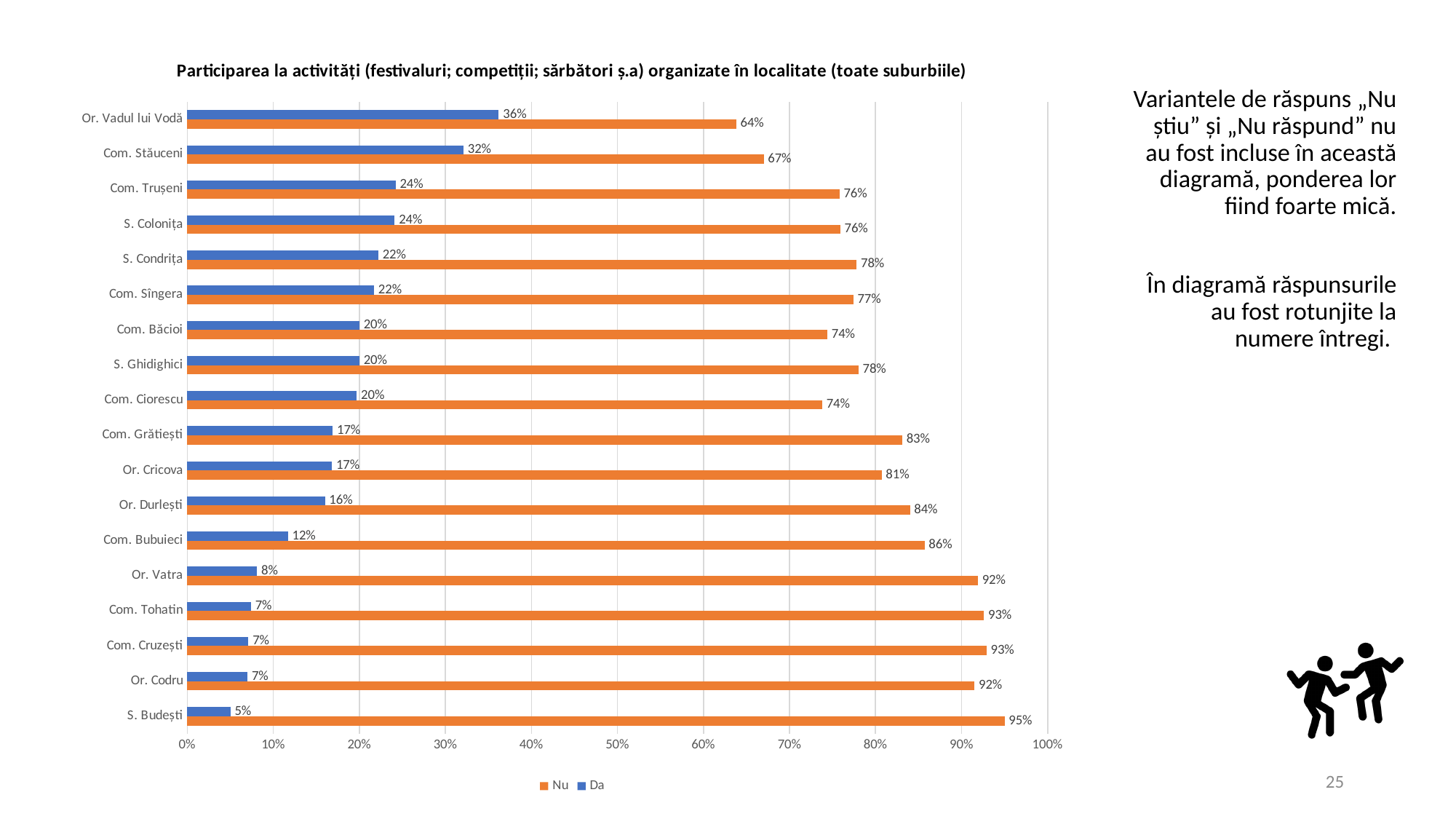
Which locality has the highest "Nu" value? S. Budești Which locality has the lowest "Da" value? S. Budești What is the difference between the "Nu" and "Da" values for Or. Durlești? 68% Which colour represents the "Nu" series? Orange How many localities are shown on the chart? 18 What is the "Nu" value for Com. Bubuieci? 86% What kind of chart is shown on the slide? Bar chart Is the "Nu" value for Or. Vatra greater or less than 90%? greater What is the "Nu" value for Com. Stăuceni? 67% Which is larger: the "Da" value for Com. Stăuceni or the "Da" value for Com. Trușeni? Com. Stăuceni What is the "Da" value for Or. Vadul lui Vodă? 36% How many series does the legend list? 2